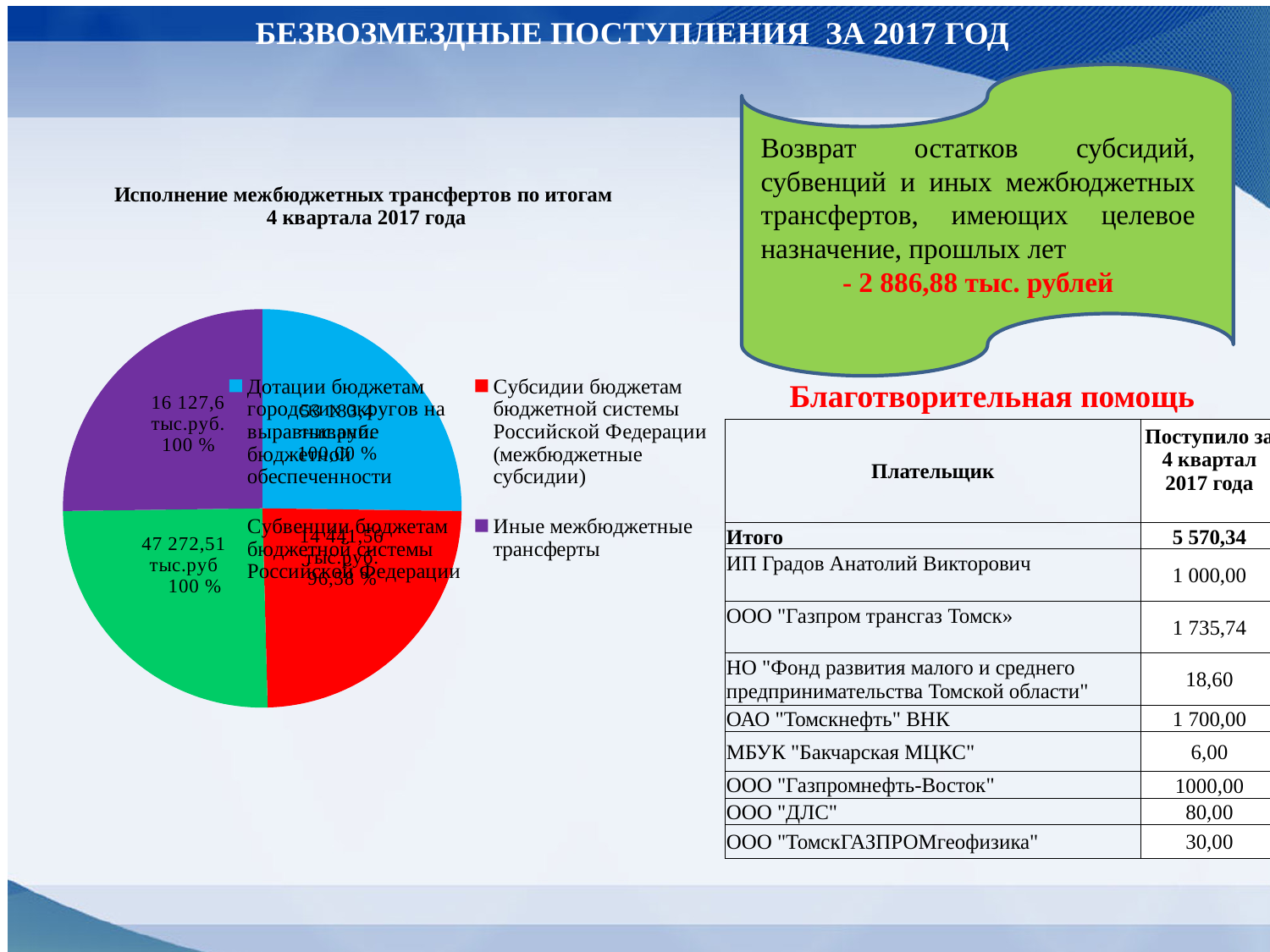
How many entries does the legend of the pie chart list? 4 What execution percentage is shown for "Субсидии бюджетам бюджетной системы Российской Федерации (межбюджетные субсидии)" in the pie chart? 96,38 % What amount is shown for "Иные межбюджетные трансферты" in the pie chart? 16 127,6 тыс.руб. Which has the larger amount in the pie chart: "Субвенции бюджетам бюджетной системы Российской Федерации" or "Иные межбюджетные трансферты"? Субвенции бюджетам бюджетной системы Российской Федерации What amount is shown for "Субсидии бюджетам бюджетной системы Российской Федерации (межбюджетные субсидии)" in the pie chart? 14 441,56 тыс.руб. What colour is the slice for "Иные межбюджетные трансферты" in the pie chart? purple How many slices does the pie chart have? 4 By how much does the amount for "Субвенции бюджетам бюджетной системы Российской Федерации" exceed the amount for "Иные межбюджетные трансферты" in the pie chart? 31 144,91 тыс.руб. What kind of chart is shown on the slide? pie chart What amount is shown for "Субвенции бюджетам бюджетной системы Российской Федерации" in the pie chart? 47 272,51 тыс.руб What execution percentage is shown for "Иные межбюджетные трансферты" in the pie chart? 100 % What is the title of the pie chart? Исполнение межбюджетных трансфертов по итогам 4 квартала 2017 года